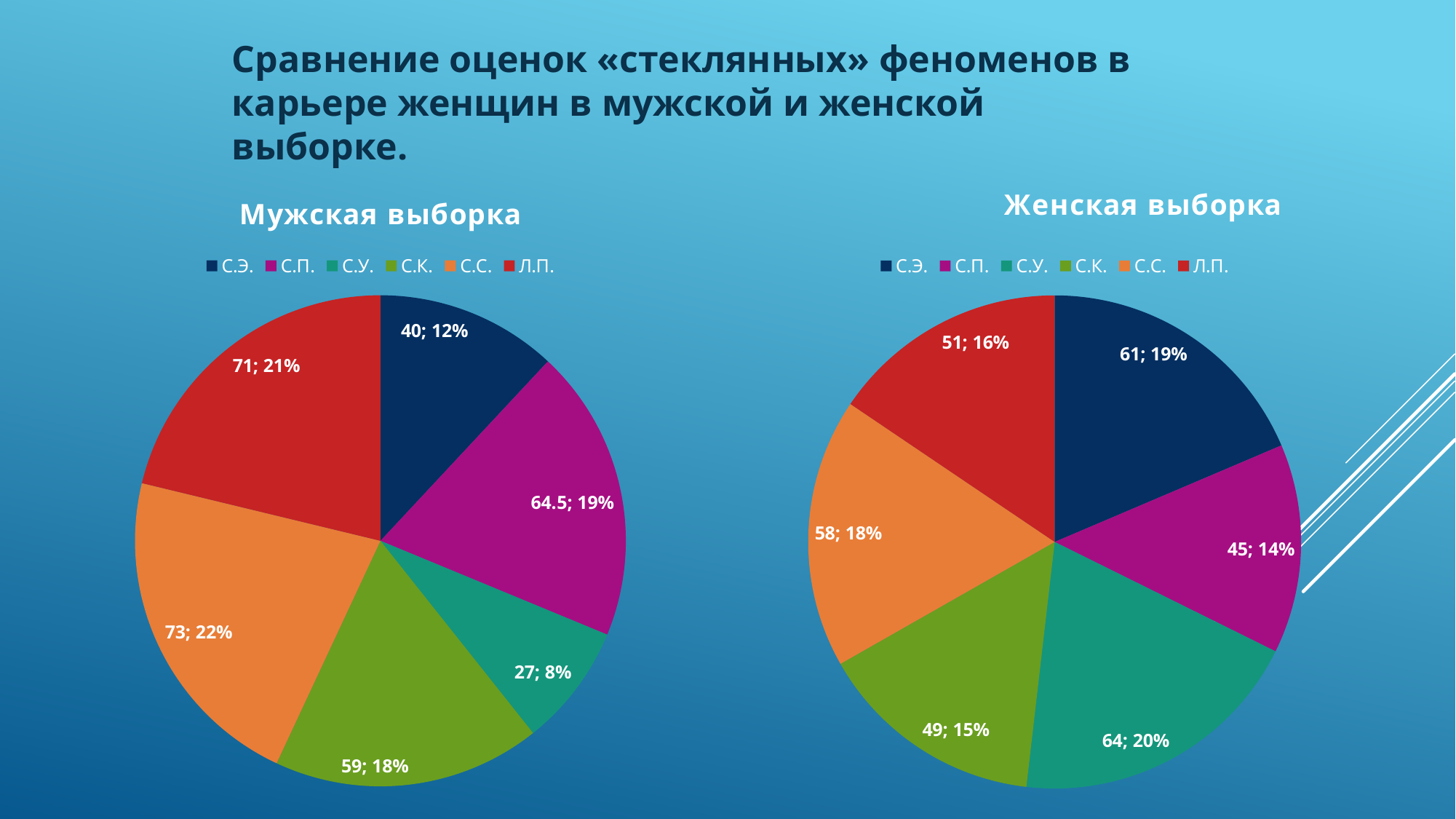
In the "Мужская выборка" chart, what value is shown for С.С.? 73 In the "Мужская выборка" chart, which category has the largest slice? С.С. How many entries does the legend of the "Мужская выборка" chart list? 6 In the "Женская выборка" chart, which category has the smallest slice? С.П. In the "Мужская выборка" chart, what is the difference between the values for Л.П. and С.Э.? 31 In the "Мужская выборка" chart, what share of the pie does С.У. have? 8% How many slices does the "Женская выборка" pie chart have? 6 In the "Женская выборка" chart, what share of the pie does Л.П. have? 16% In the "Женская выборка" chart, which is larger, the value for С.Э. or the value for С.К.? С.Э. What kind of chart is used for the "Мужская выборка" chart? pie chart In the "Мужская выборка" chart, which category has the smallest slice? С.У. In the "Женская выборка" chart, what value is shown for С.У.? 64